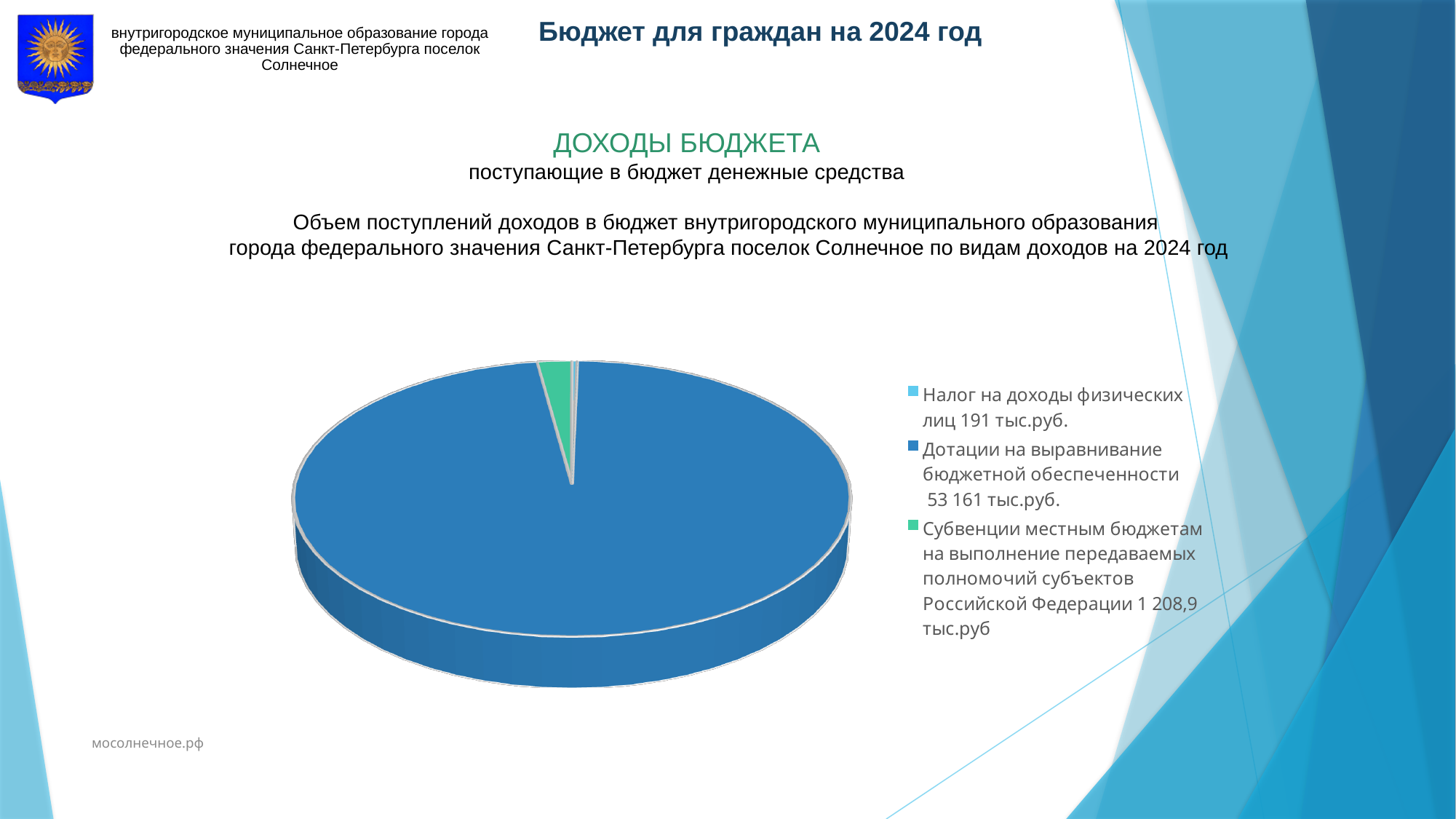
What is the difference between «Субвенции местным бюджетам» and «Налог на доходы физических лиц»? 1 017,9 тыс.руб. What is the value for «Дотации на выравнивание бюджетной обеспеченности» in the pie chart? 53 161 тыс.руб. Which category has the smallest slice in the pie chart? Налог на доходы физических лиц What colour is the slice for «Субвенции местным бюджетам» in the pie chart? Green Which category has the largest slice in the pie chart? Дотации на выравнивание бюджетной обеспеченности How many entries does the legend of the pie chart list? 3 What is the value for «Субвенции местным бюджетам на выполнение передаваемых полномочий субъектов Российской Федерации» in the pie chart? 1 208,9 тыс.руб What is the difference between «Дотации на выравнивание бюджетной обеспеченности» and «Налог на доходы физических лиц»? 52 970 тыс.руб. Which is larger: «Субвенции местным бюджетам» or «Налог на доходы физических лиц»? Субвенции местным бюджетам What is the value for «Налог на доходы физических лиц» in the pie chart? 191 тыс.руб. How many slices does the pie chart have? 3 What kind of chart is shown on the slide? Pie chart